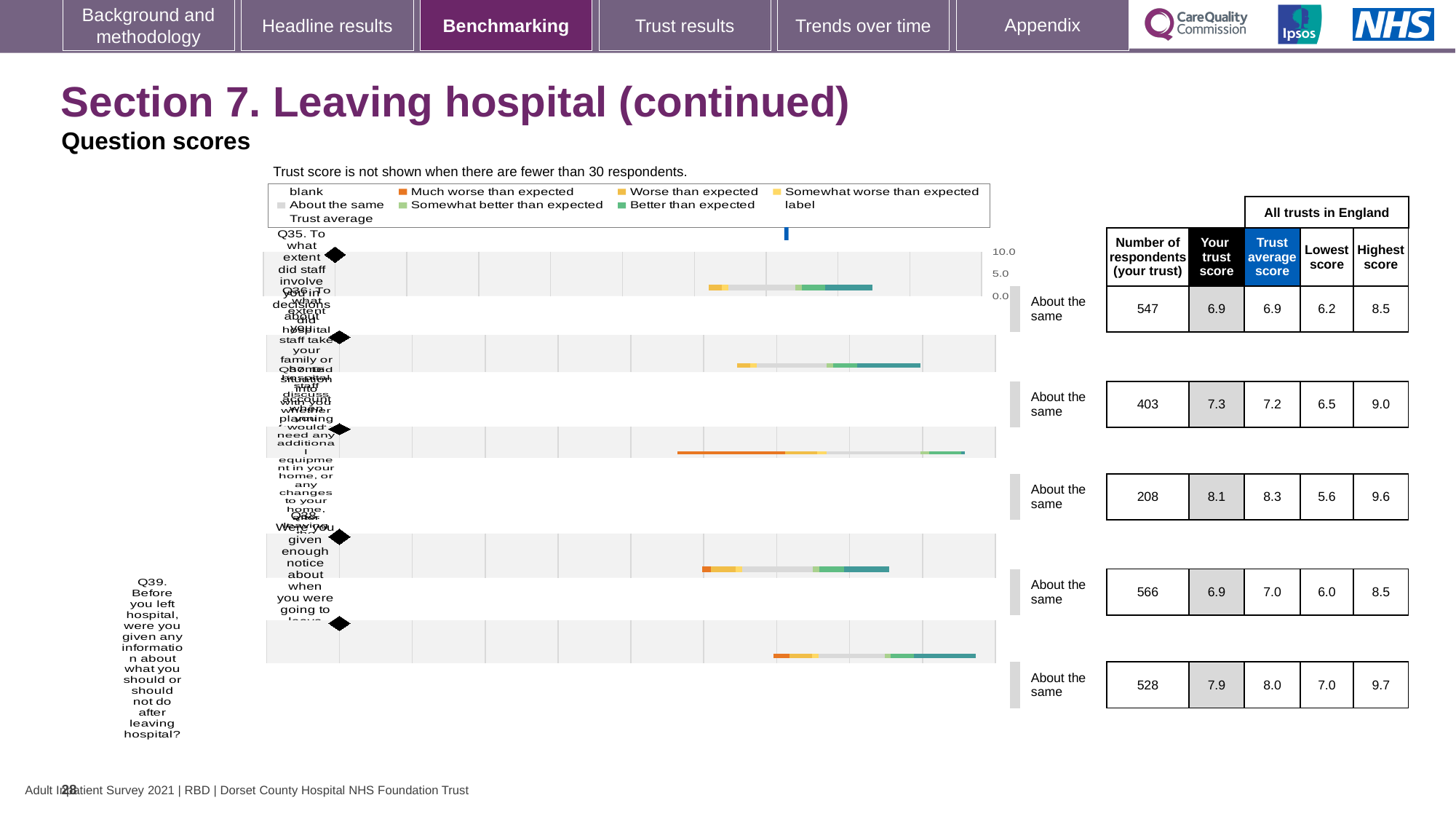
What is the smallest number of respondents shown for any question in the table? 208 What is the number of respondents (your trust) for Q35? 547 What benchmark category is shown for every question on this slide? About the same Which question has the largest number of respondents? Q38 For Q39, which is larger: your trust score or the trust average score? Trust average score What is the trust score for Q39 (information about what you should or should not do after leaving hospital)? 7.9 What is the highest score across all trusts in England for Q39? 9.7 What is the trust average score for Q36? 7.2 For Q35, what is the difference between the highest score and the lowest score across all trusts in England? 2.3 What kind of chart is used to show the question scores on this slide? bar chart How many questions (rows) are shown in the question scores chart? 5 What is the lowest score across all trusts in England for Q38 (enough notice about when you were going to leave)? 6.0